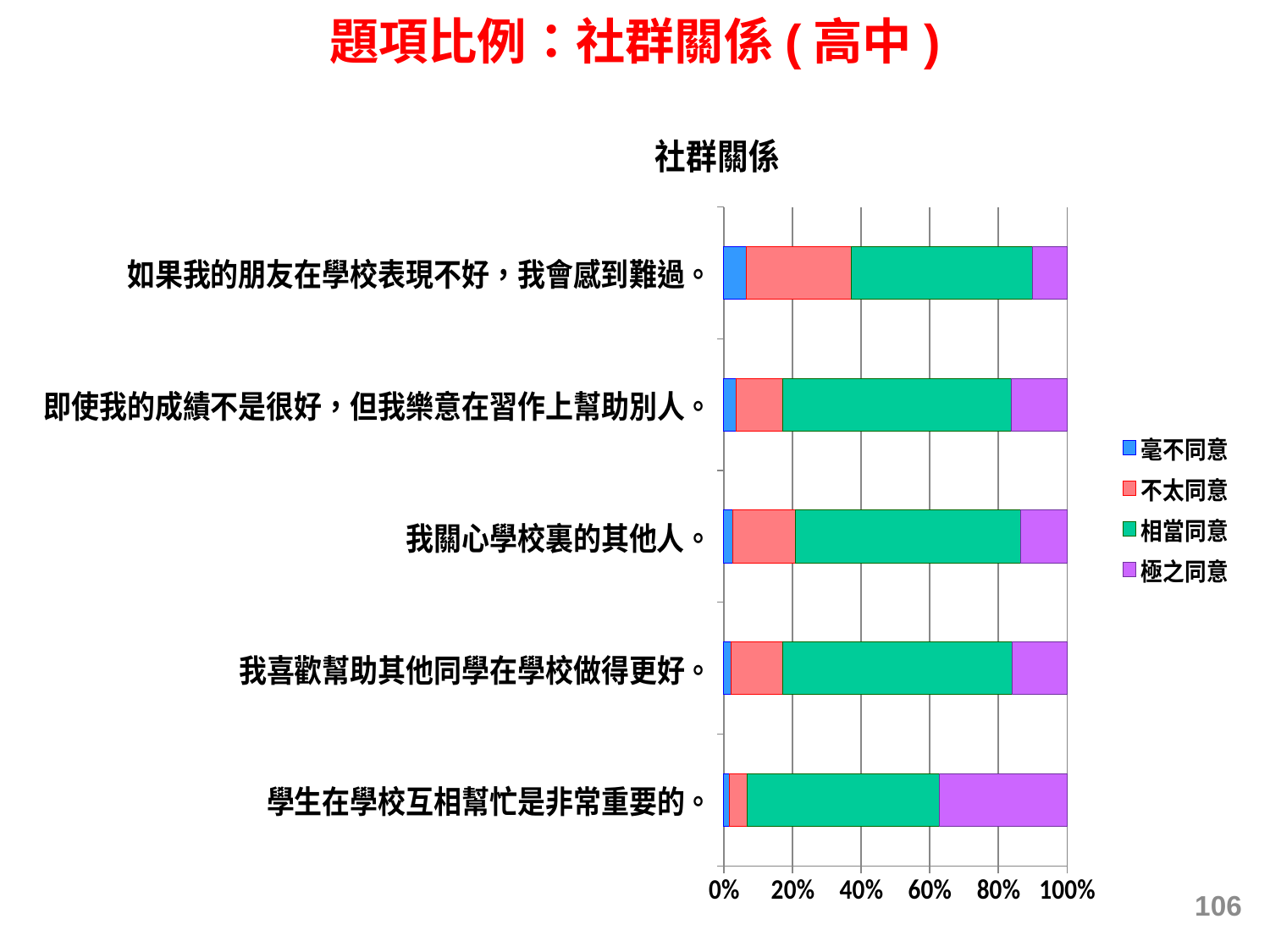
How many series does the legend list? 4 Which statement has the smallest 不太同意 segment? 學生在學校互相幫忙是非常重要的。 Which legend entry is shown in green? 相當同意 Is the 不太同意 share for 「如果我的朋友在學校表現不好，我會感到難過。」 greater or less than 20%? greater Is the 相當同意 share for 「學生在學校互相幫忙是非常重要的。」 greater or less than 40%? greater What is the total of each stacked bar in the chart? 100% How many statements (categories) are plotted in the chart? 5 Which statement has the largest 極之同意 segment? 學生在學校互相幫忙是非常重要的。 What kind of chart is shown on the slide? stacked bar chart What is the title of the chart? 社群關係 Is the 極之同意 share for 「學生在學校互相幫忙是非常重要的。」 greater or less than 20%? greater Which statement has a larger 不太同意 segment: 「如果我的朋友在學校表現不好，我會感到難過。」 or 「學生在學校互相幫忙是非常重要的。」? 如果我的朋友在學校表現不好，我會感到難過。